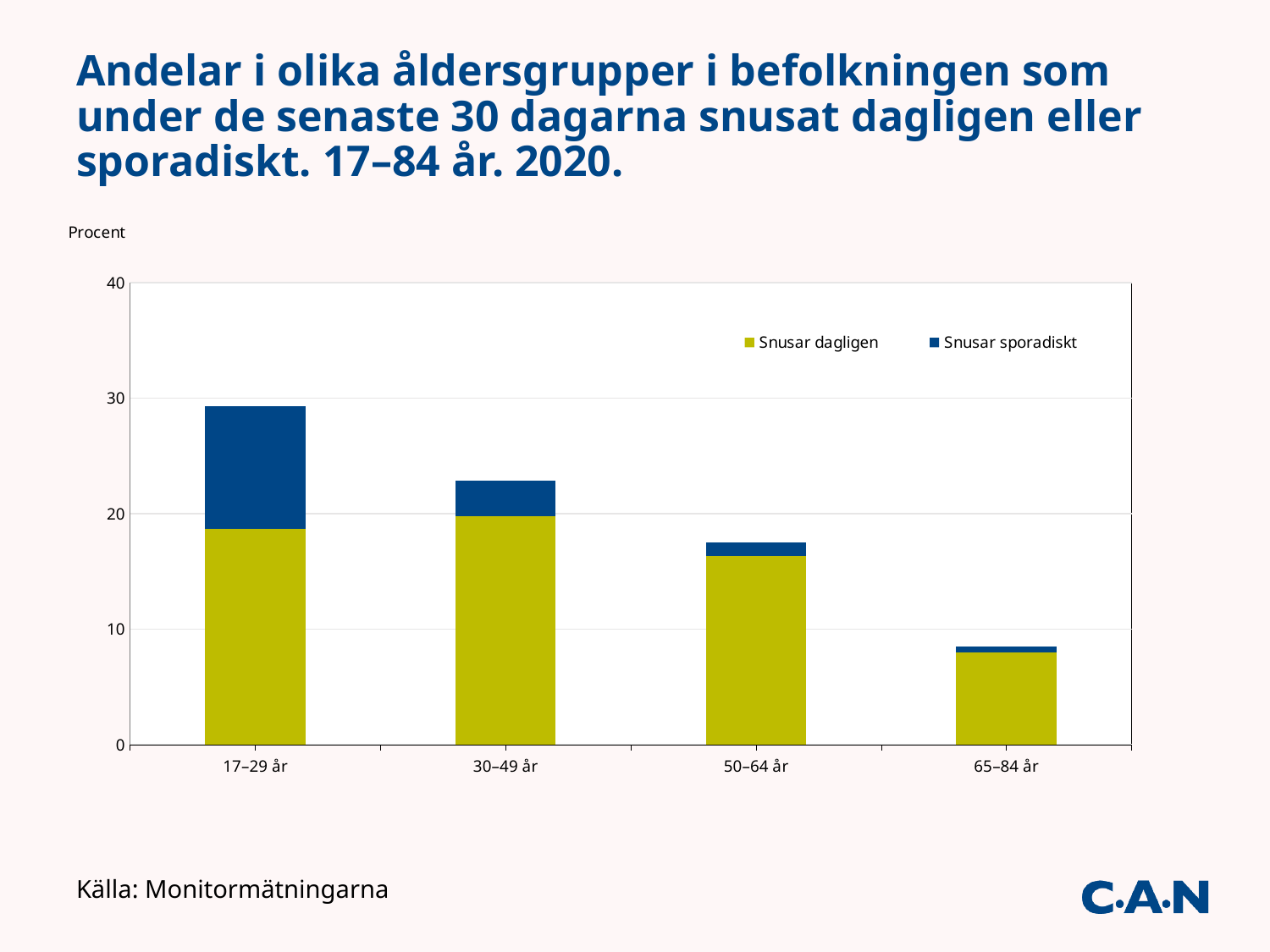
How many series does the legend list? 2 Is the 'Snusar dagligen' value for 17–29 år greater or less than 20? less Which age group has the shortest stacked bar? 65–84 år Is the total stacked bar for 50–64 år greater or less than 20? less Is the total stacked bar for 30–49 år greater or less than 20? greater How many age groups are shown on the x axis? 4 Which has the larger total stacked bar, 30–49 år or 50–64 år? 30–49 år Which series is shown in dark blue in the legend? Snusar sporadiskt Which age group has the tallest stacked bar? 17–29 år What kind of chart is shown on the slide? stacked bar chart Do the total stacked bar heights rise or fall from the youngest to the oldest age group? fall